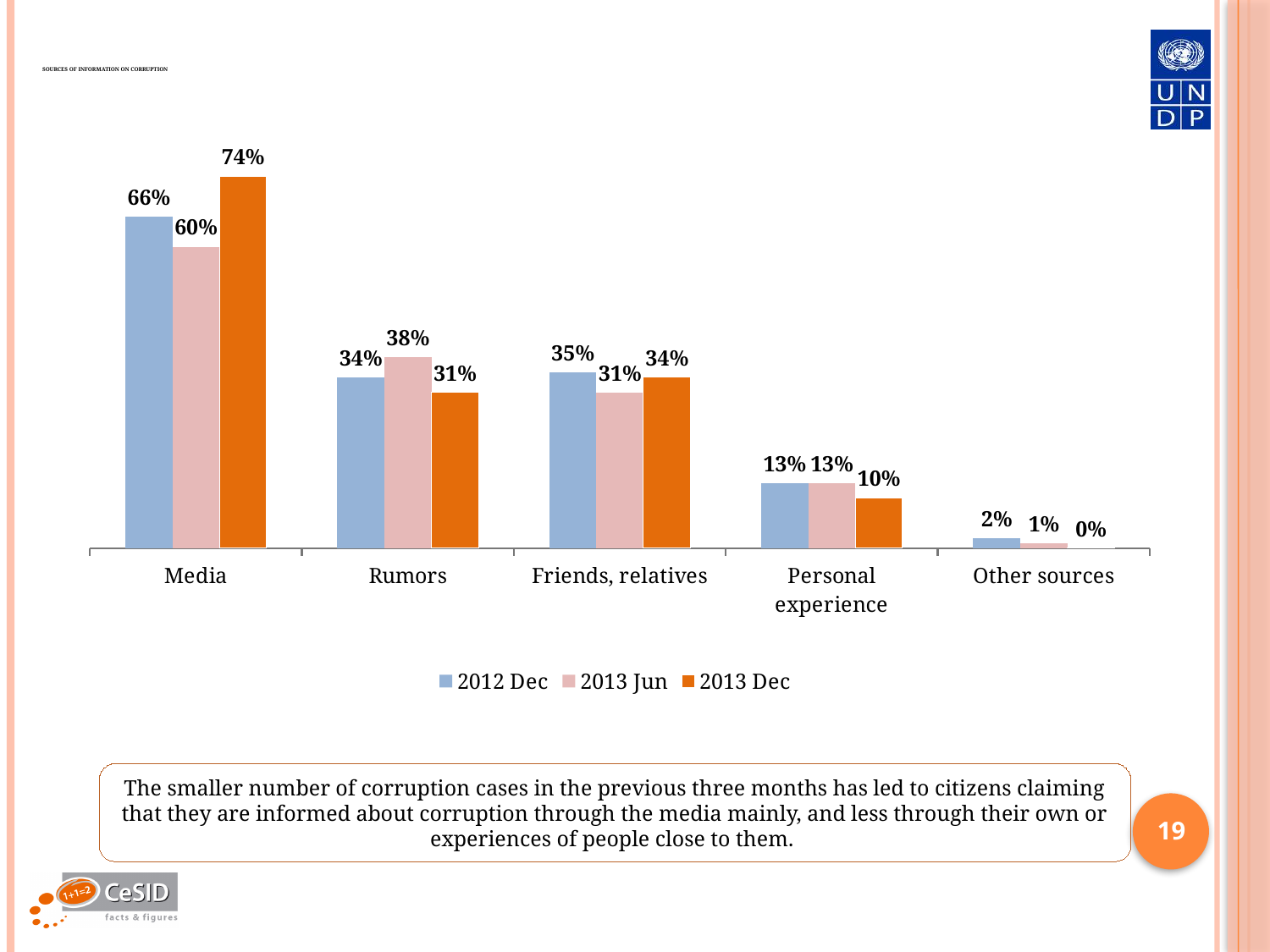
What is the difference between the 2013 Dec and 2012 Dec values for Media? 8% What kind of chart is shown on the slide? Bar chart What is the value for Media in the 2013 Dec series? 74% Which is larger for Friends, relatives: the 2012 Dec value or the 2013 Jun value? 2012 Dec Which category has the highest value in the 2012 Dec series? Media What is the value for Rumors in the 2013 Jun series? 38% How many series does the legend list? 3 Which category has the lowest value in the 2013 Dec series? Other sources Which series is shown in orange in the legend? 2013 Dec What is the value for Personal experience in the 2012 Dec series? 13% How many categories are shown on the x axis? 5 Do the values in the 2013 Dec series rise or fall from Media to Other sources? Neither consistently; they fall overall but rise from Rumors (31%) to Friends, relatives (34%)